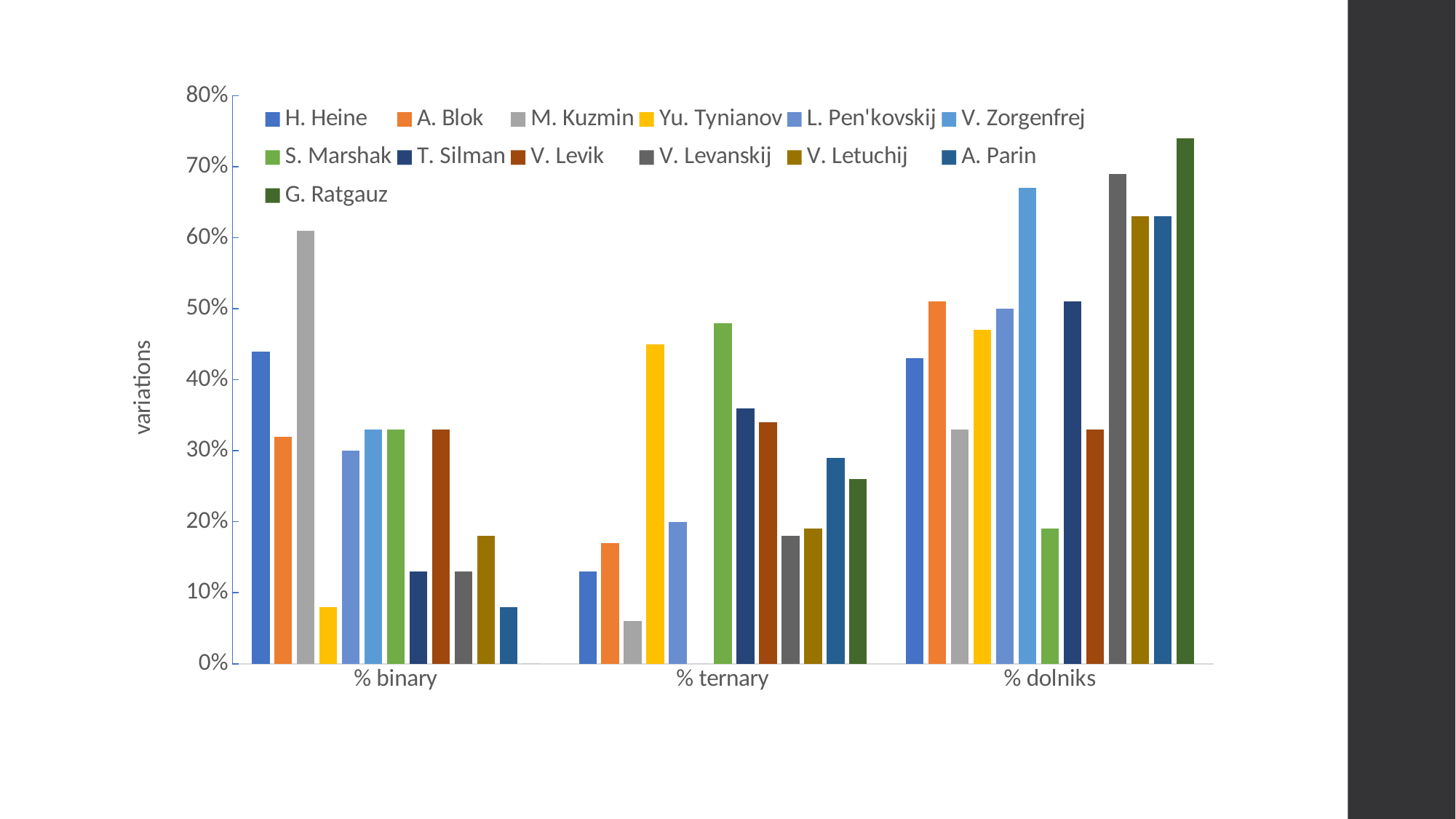
Is the value for M. Kuzmin in % binary greater or less than 50%? greater What kind of chart is shown on the slide? bar chart Which series has the lowest value in the % ternary category? V. Zorgenfrej Which is larger for V. Zorgenfrej: the % binary value or the % dolniks value? % dolniks Is the value for H. Heine in % ternary greater or less than 20%? less Which series has the lowest value in the % dolniks category? S. Marshak Is the value for G. Ratgauz in % dolniks greater or less than 70%? greater How many series does the legend list? 13 How many categories are shown on the x axis? 3 Which series has the highest value in the % binary category? M. Kuzmin What is the title of the vertical axis? variations Which series has the highest value in the % dolniks category? G. Ratgauz